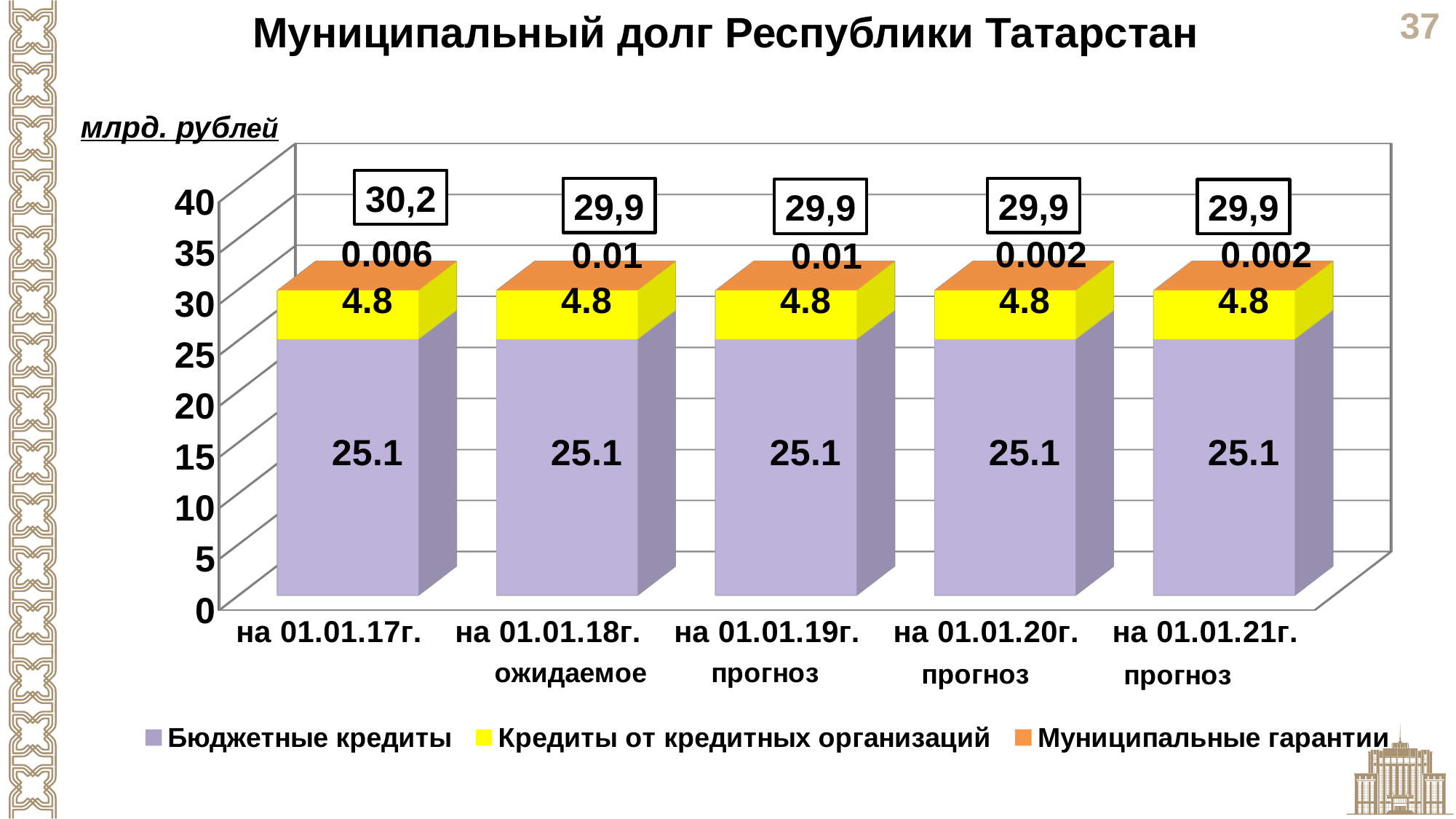
What is the value of Муниципальные гарантии for на 01.01.18г. ожидаемое? 0.01 What is the value of Муниципальные гарантии for на 01.01.21г. прогноз? 0.002 What total is printed above the bar for на 01.01.20г. прогноз? 29,9 Which series has the largest value in the bar for на 01.01.20г. прогноз? Бюджетные кредиты How many series does the legend list? 3 What is the value of Бюджетные кредиты for на 01.01.17г.? 25.1 What kind of chart is shown on the slide? stacked bar chart What is the value of Кредиты от кредитных организаций for на 01.01.19г. прогноз? 4.8 How many categories are shown on the x axis? 5 Which category has the highest value for Муниципальные гарантии? на 01.01.18г. ожидаемое and на 01.01.19г. прогноз (0.01) Is the value for Бюджетные кредиты for на 01.01.19г. прогноз greater or less than 20? greater What total is printed above the bar for на 01.01.17г.? 30,2